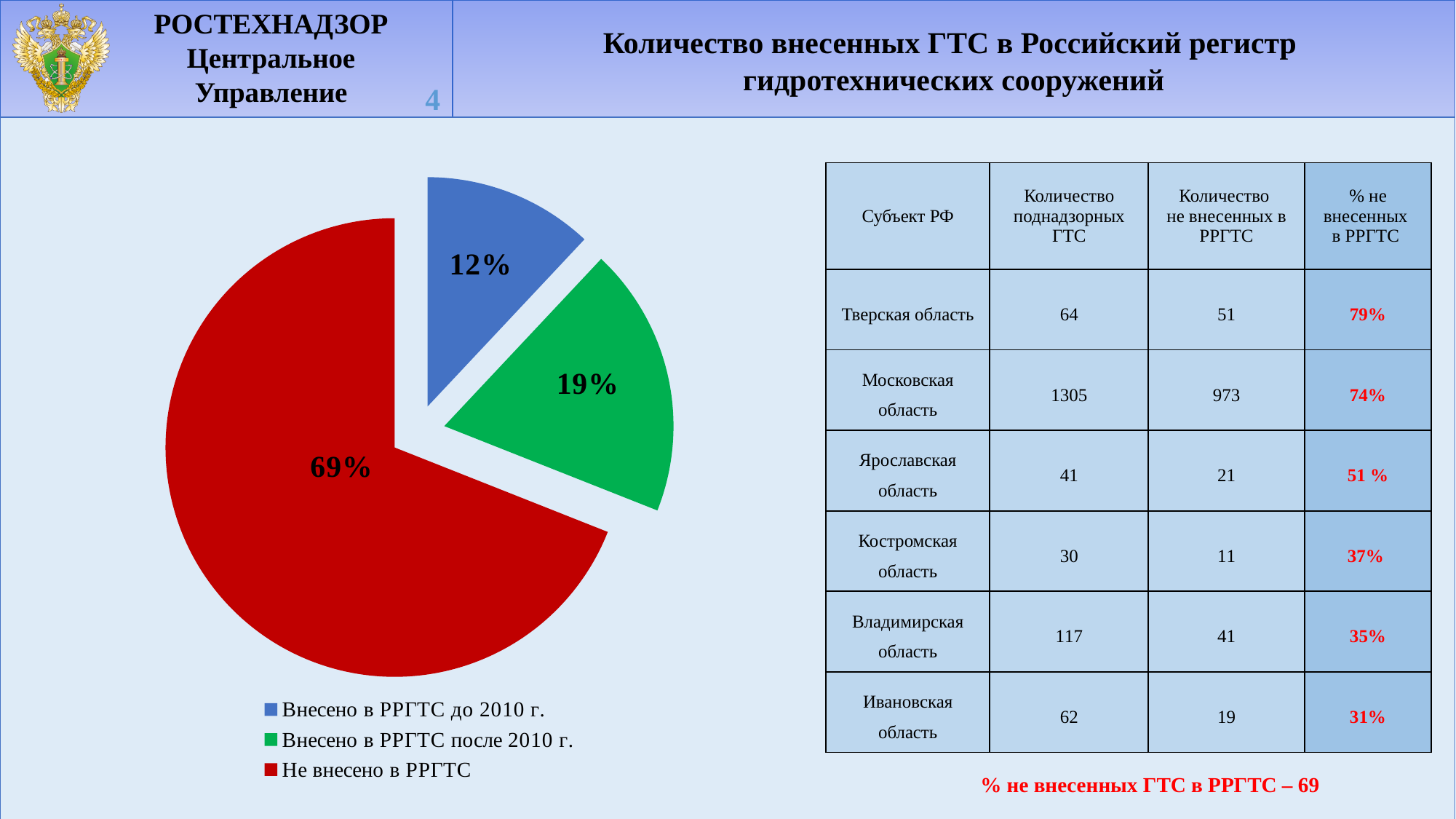
What type of chart is shown on the slide? pie chart What colour is the slice for "Внесено в РРГТС после 2010 г."? green What share of the pie does "Внесено в РРГТС после 2010 г." represent? 19% How many slices does the pie chart have? 3 What share of the pie does "Не внесено в РРГТС" represent? 69% Which slice of the pie chart is the largest? Не внесено в РРГТС How many entries does the legend of the pie chart list? 3 What is the difference in percentage points between the "Не внесено в РРГТС" slice and the "Внесено в РРГТС после 2010 г." slice? 50 What colour is the slice for "Не внесено в РРГТС"? red What share of the pie does "Внесено в РРГТС до 2010 г." represent? 12% Which slice of the pie chart is the smallest? Внесено в РРГТС до 2010 г. Which is larger: the share for "Внесено в РРГТС до 2010 г." or the share for "Внесено в РРГТС после 2010 г."? Внесено в РРГТС после 2010 г.